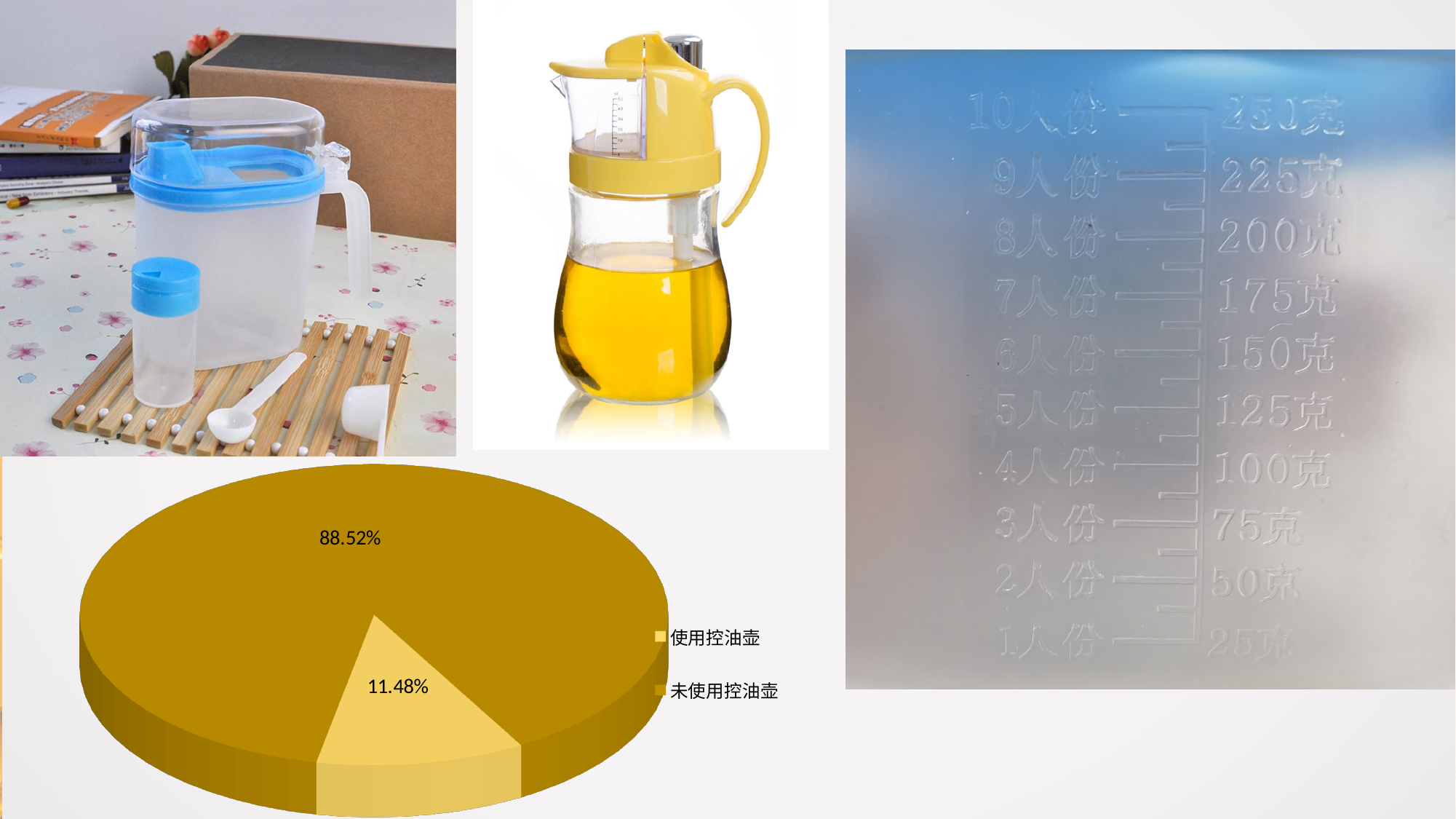
What percentage does the pie chart show for 未使用控油壶? 11.48% What is the difference between the two percentages shown on the pie chart? 77.04% What kind of chart is shown at the bottom left of the slide? pie chart What is the smallest value shown on the pie chart? 11.48% Which category has the larger share in the pie chart, 使用控油壶 or 未使用控油壶? 使用控油壶 What is the largest value shown on the pie chart? 88.52% How many slices does the pie chart have? 2 What are the two legend entries of the pie chart? 使用控油壶, 未使用控油壶 How many entries does the pie chart's legend list? 2 What share of the pie does the light yellow slice represent? 11.48% What percentage does the pie chart show for 使用控油壶? 88.52% Is the value for 使用控油壶 greater or less than 50%? greater